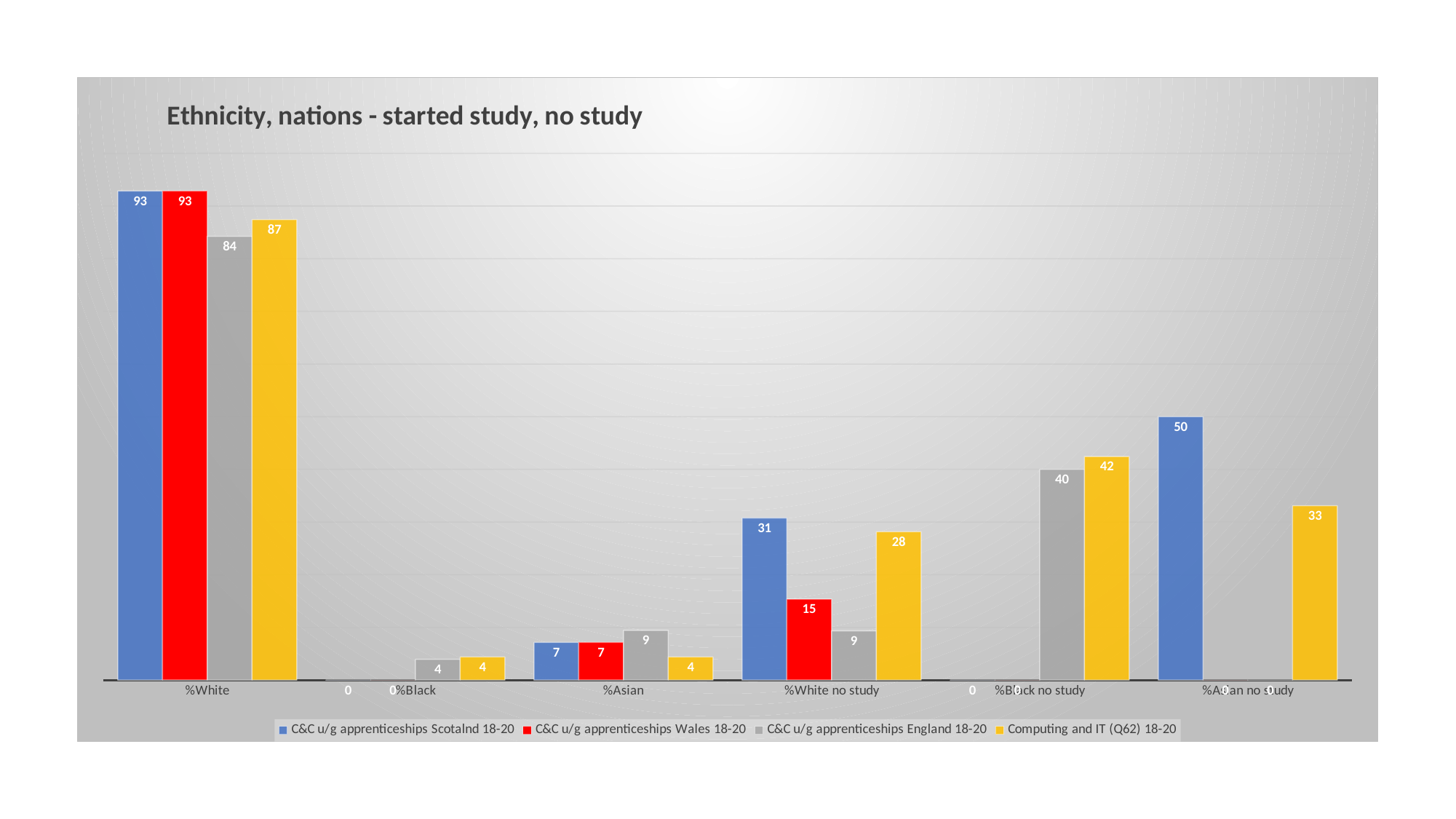
What is the value for C&C u/g apprenticeships Wales 18-20 in the %White no study category? 15 What is the value for C&C u/g apprenticeships Scotalnd 18-20 in the %Asian no study category? 50 How many categories are shown on the x axis? 6 What is the value for Computing and IT (Q62) 18-20 in the %White no study category? 28 What is the title of the chart? Ethnicity, nations - started study, no study Which category has the highest value for C&C u/g apprenticeships England 18-20? %White What is the value for C&C u/g apprenticeships England 18-20 in the %White category? 84 What type of chart is shown on the slide? Bar chart How many series does the legend list? 4 In the %White no study category, which is larger: the value for C&C u/g apprenticeships Scotalnd 18-20 or for C&C u/g apprenticeships Wales 18-20? C&C u/g apprenticeships Scotalnd 18-20 Which series is shown in red? C&C u/g apprenticeships Wales 18-20 What is the difference between the Computing and IT (Q62) 18-20 value and the C&C u/g apprenticeships England 18-20 value in the %Black no study category? 2